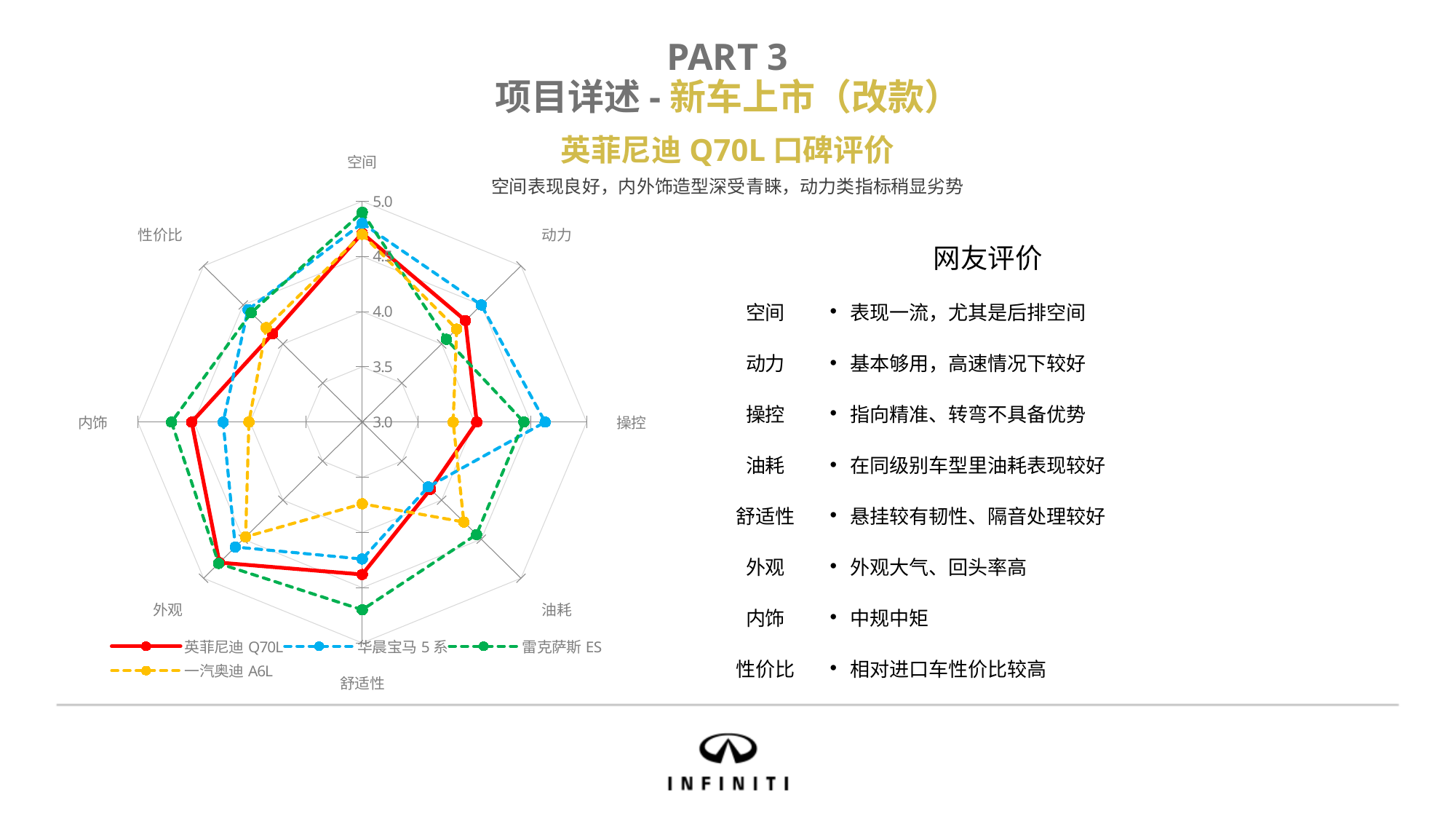
Is the value for 雷克萨斯 ES on the 内饰 axis greater or less than 4.5? greater Which series has the highest value on the 内饰 axis? 雷克萨斯 ES How many categories (axes) does the radar chart have? 8 Which series has the lowest value on the 内饰 axis? 一汽奥迪 A6L What kind of chart is shown on the slide? Radar chart Which series has the highest value on the 操控 axis? 华晨宝马 5 系 Is the value for 一汽奥迪 A6L on the 舒适性 axis greater or less than 4.0? less How many series does the legend of the radar chart list? 4 Which series is drawn with the solid red line in the radar chart? 英菲尼迪 Q70L Is the value for 英菲尼迪 Q70L on the 空间 axis greater or less than 4.5? greater On the 内饰 axis, which is larger: 英菲尼迪 Q70L or 华晨宝马 5 系? 英菲尼迪 Q70L Which series has the lowest value on the 舒适性 axis? 一汽奥迪 A6L